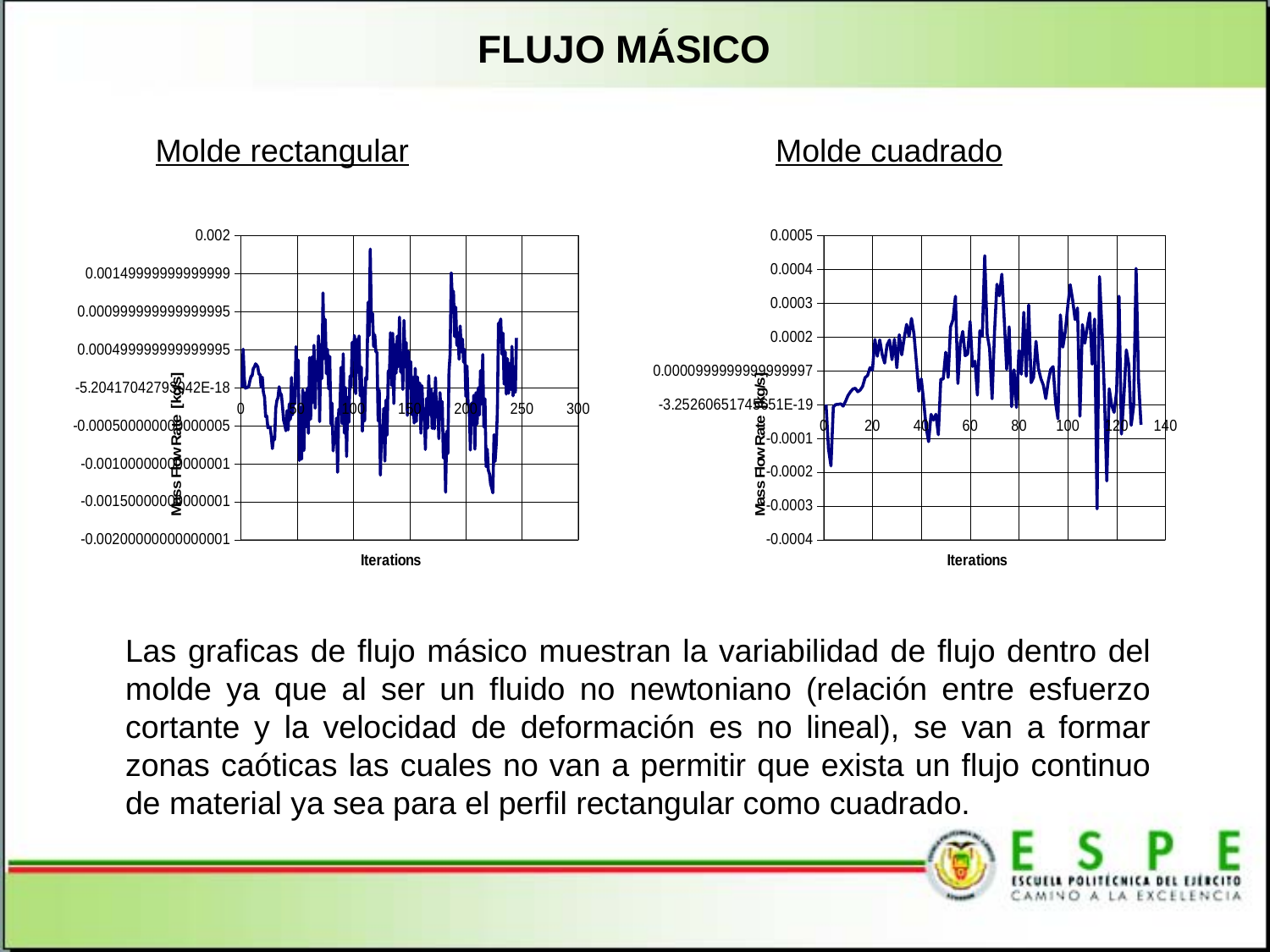
In the 'Molde cuadrado' chart, what is the highest tick shown on the x axis? 140 In the 'Molde rectangular' chart, does the line rise steadily, fall steadily, or fluctuate along the x axis? fluctuate In the 'Molde cuadrado' chart, is the lowest value reached by the line greater or less than -0.0002? less In the 'Molde rectangular' chart, what is the label of the x axis? Iterations In the 'Molde rectangular' chart, what is the highest tick shown on the x axis? 300 What kind of chart is shown under 'Molde rectangular'? line chart How many charts are on the slide? 2 In the 'Molde cuadrado' chart, what is the highest tick shown on the y axis? 0.0005 In the 'Molde cuadrado' chart, is the highest value reached by the line greater or less than 0.0004? greater In the 'Molde cuadrado' chart, what is the label of the y axis? Mass Flow Rate [kg/s] In the 'Molde rectangular' chart, is the highest value reached by the line greater or less than 0.0015? greater What kind of chart is shown under 'Molde cuadrado'? line chart